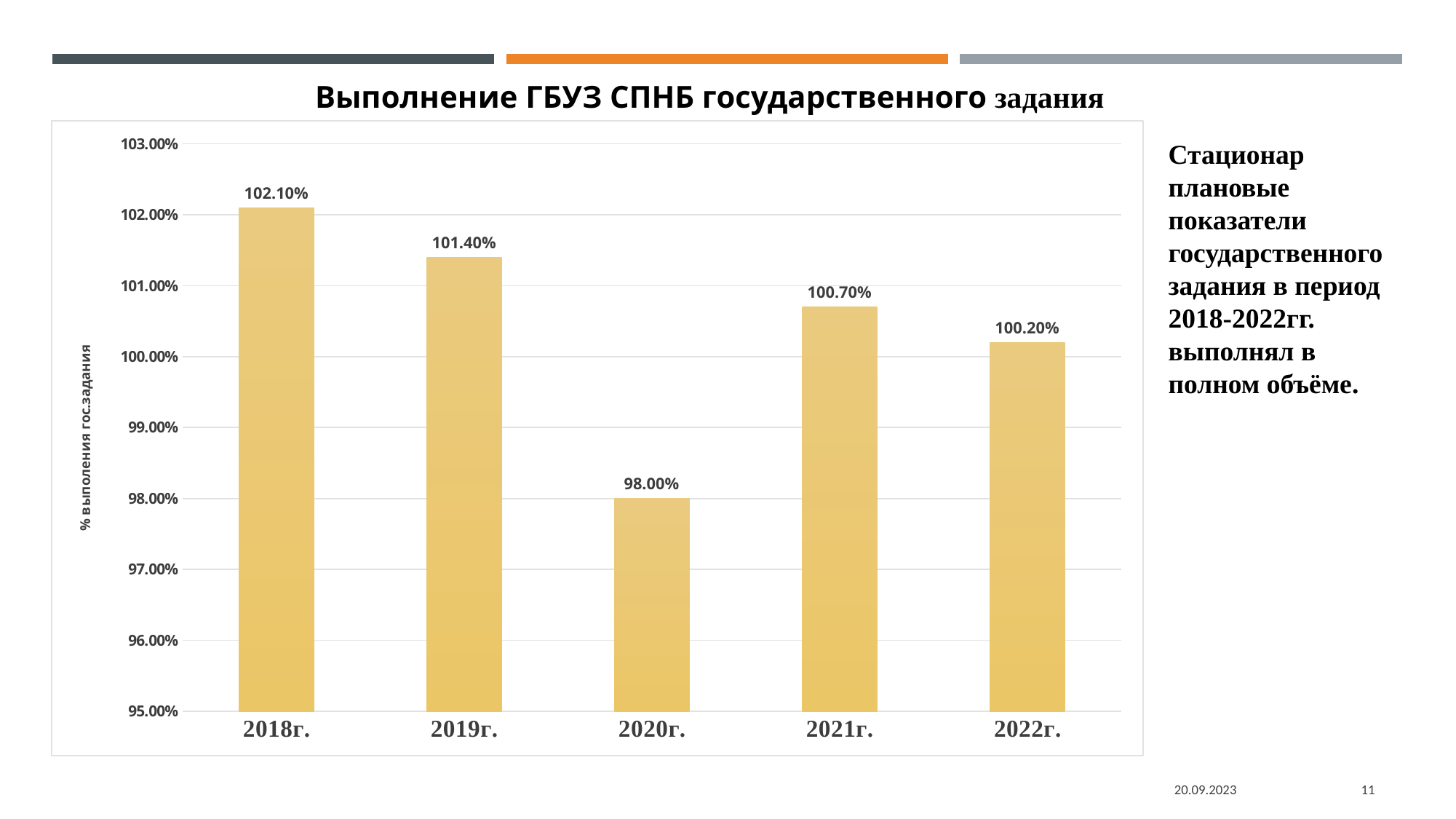
Which year has the highest value? 2018г. What is the value for 2018г.? 102.10% What is the label of the vertical axis? % выполнения гос.задания What kind of chart is shown on the slide? bar chart Which year has the lowest value? 2020г. How many years are shown on the x axis? 5 Which is larger, the value for 2021г. or the value for 2022г.? 2021г. What is the value for 2022г.? 100.20% What is the value for 2020г.? 98.00% Is the value for 2020г. greater or less than 100.00%? less What is the difference between the values for 2021г. and 2020г.? 2.70% What is the difference between the values for 2018г. and 2019г.? 0.70%